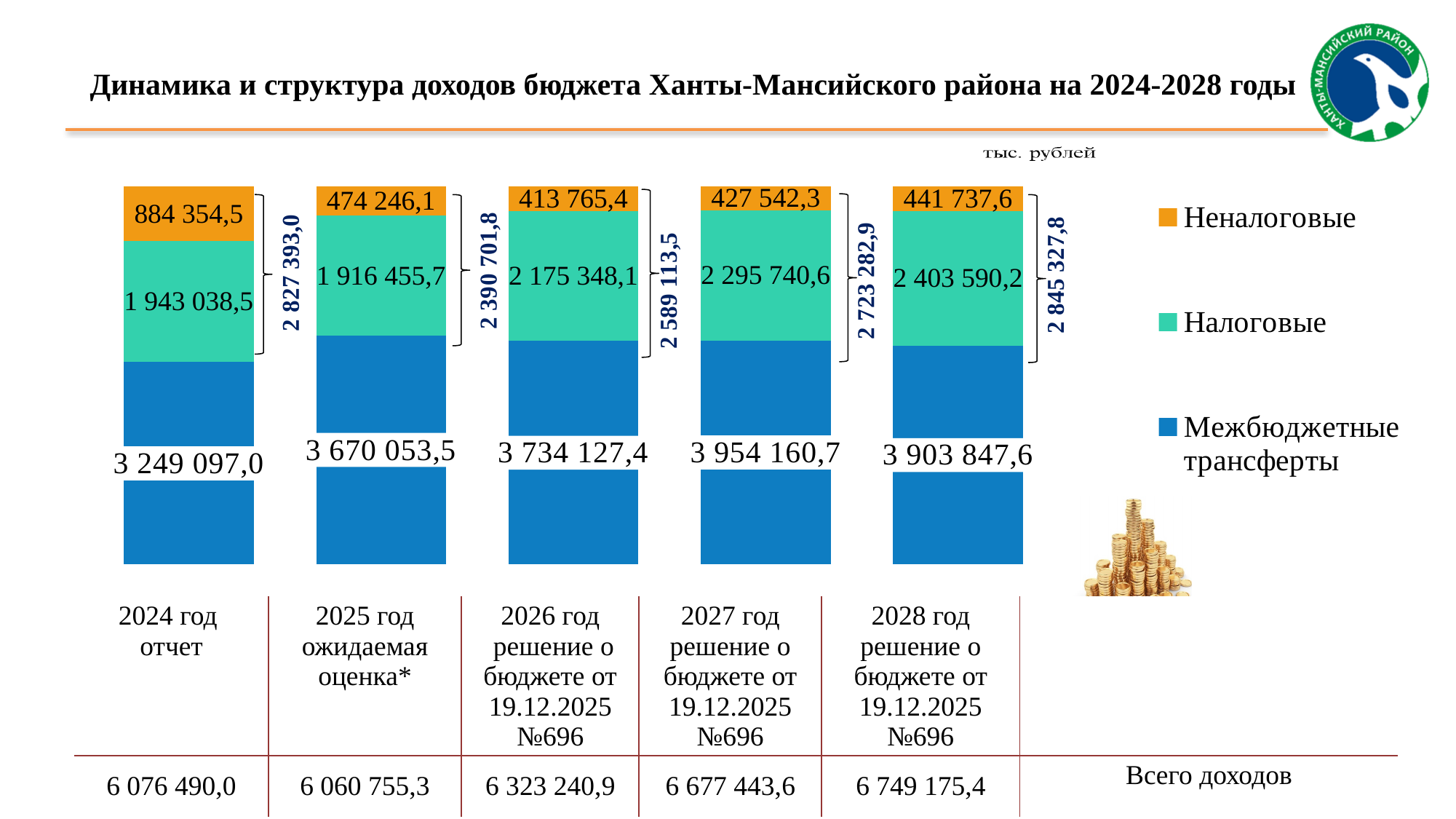
Which year has the larger Межбюджетные трансферты value, 2027 год or 2028 год? 2027 год What kind of chart is shown on the slide? Stacked bar chart Does the Налоговые value rise or fall from 2025 год to 2028 год? Rises By how much does the Налоговые value for 2028 год exceed the Налоговые value for 2024 год? 460 551,7 How many years (categories) are shown on the chart? 5 What is the value of Неналоговые for 2028 год? 441 737,6 What is the value of Налоговые for 2026 год? 2 175 348,1 What is the total income (Всего доходов) for 2026 год? 6 323 240,9 In which year is the Неналоговые value the highest? 2024 год What is the value of Межбюджетные трансферты for 2024 год? 3 249 097,0 How many series does the legend list? 3 In which year is the Межбюджетные трансферты value the lowest? 2024 год